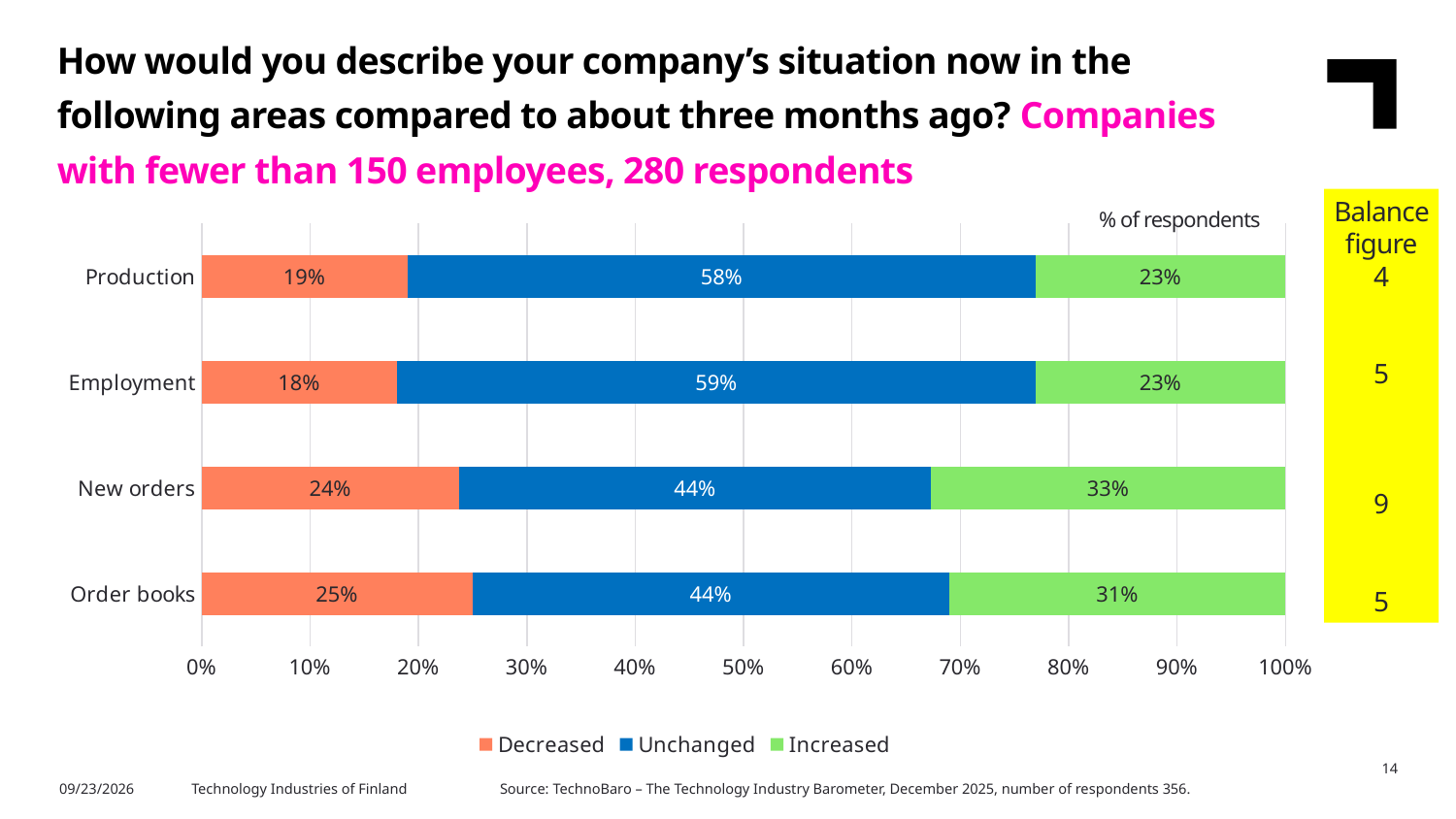
Which category has the lowest share of Decreased responses? Employment Which category has the highest share of Increased responses? New orders What kind of chart is shown on the slide? Stacked bar chart What percentage of respondents reported Order books as Decreased? 25% How many series does the legend list? 3 What percentage of respondents reported Employment as Unchanged? 59% Which has a larger Increased share, Order books or Production? Order books What percentage of respondents reported New orders as Increased? 33% What is the difference between the Unchanged share for Employment and the Unchanged share for New orders? 15% How many categories are shown on the chart? 4 What is the balance figure shown for New orders? 9 What percentage of respondents reported Production as Unchanged? 58%